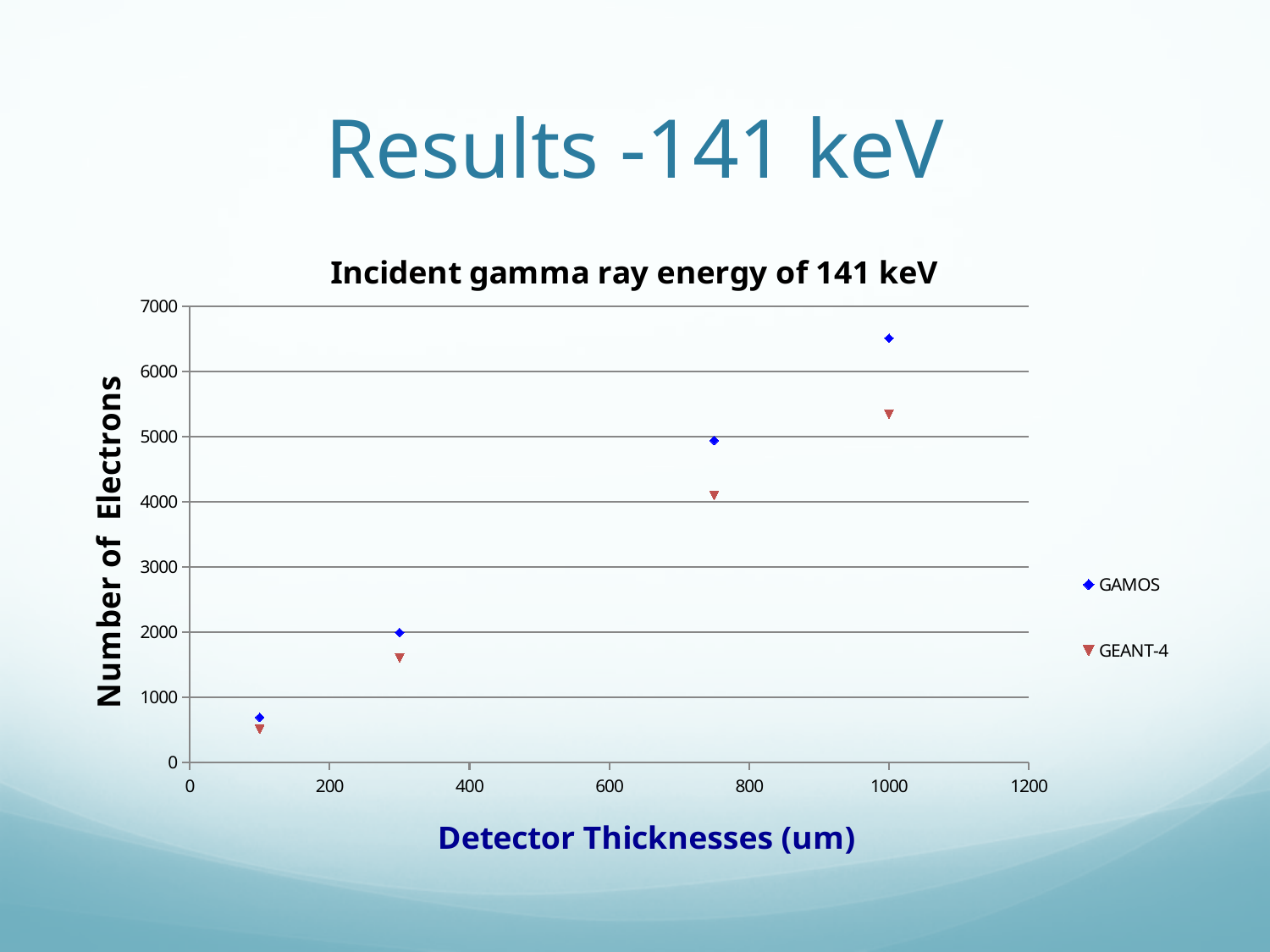
Is the GEANT-4 value at a detector thickness of 1000 um greater or less than 6000? less How many data points are plotted for the GAMOS series? 4 What kind of chart is shown on the slide? scatter chart What is the title of the chart? Incident gamma ray energy of 141 keV Is the GAMOS value at a detector thickness of 1000 um greater or less than 6000? greater How many series does the legend list? 2 Does the number of electrons rise or fall as detector thickness increases? rise Which two series are listed in the legend? GAMOS and GEANT-4 Is the GEANT-4 value at a detector thickness of 300 um greater or less than 2000? less At a detector thickness of 1000 um, which series has the larger number of electrons, GAMOS or GEANT-4? GAMOS Which series contains the highest plotted point on the chart? GAMOS